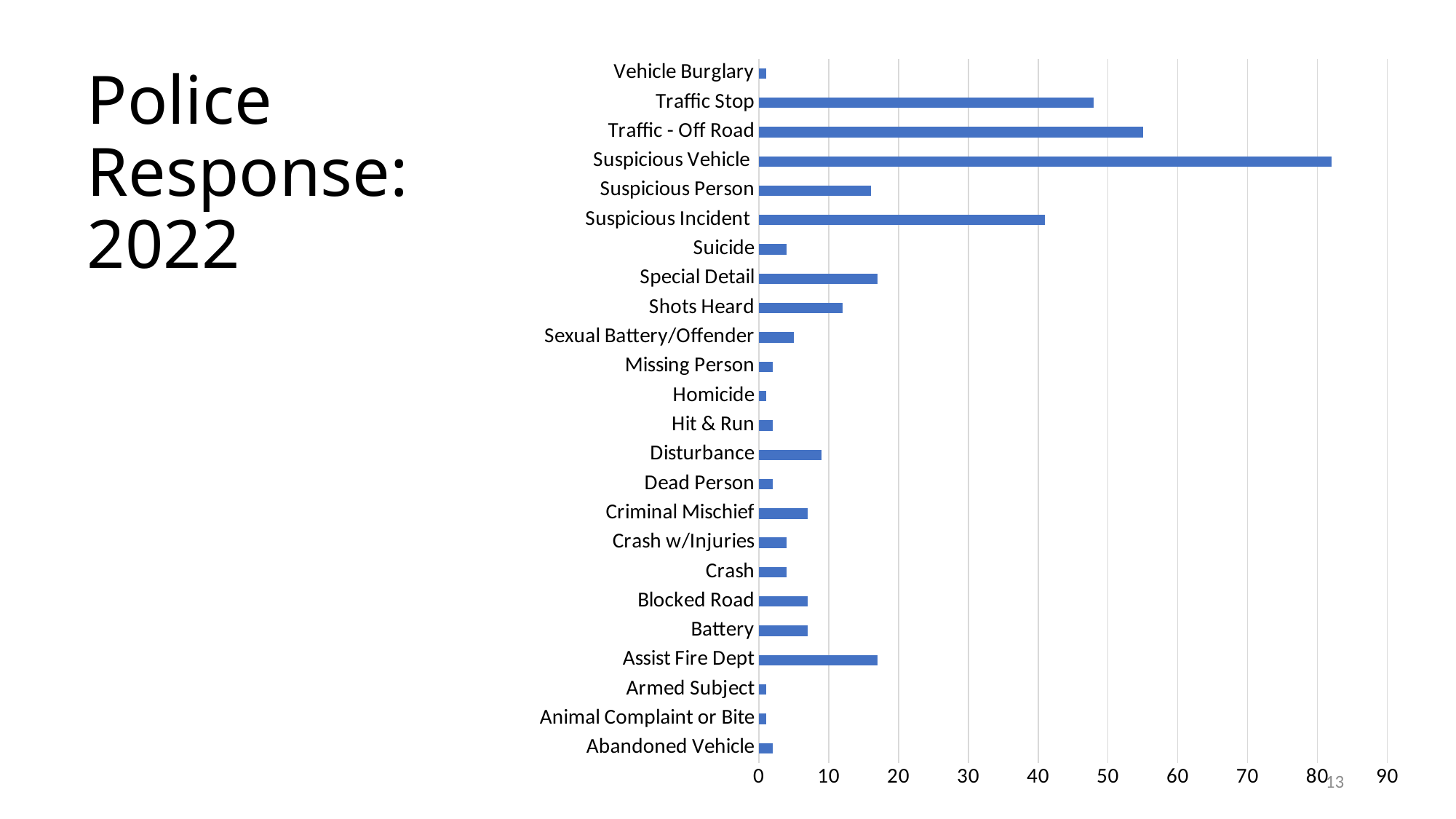
Which is larger, Suspicious Incident or Suspicious Person? Suspicious Incident How many categories are plotted on the chart? 24 Is the value for Traffic Stop greater or less than 40? greater Is the value for Special Detail greater or less than 10? greater What is the title of the slide containing the chart? Police Response: 2022 Is the value for Suspicious Incident greater or less than 50? less What kind of chart is shown on the slide? bar chart Which is larger, Traffic - Off Road or Traffic Stop? Traffic - Off Road Which category has the highest value? Suspicious Vehicle